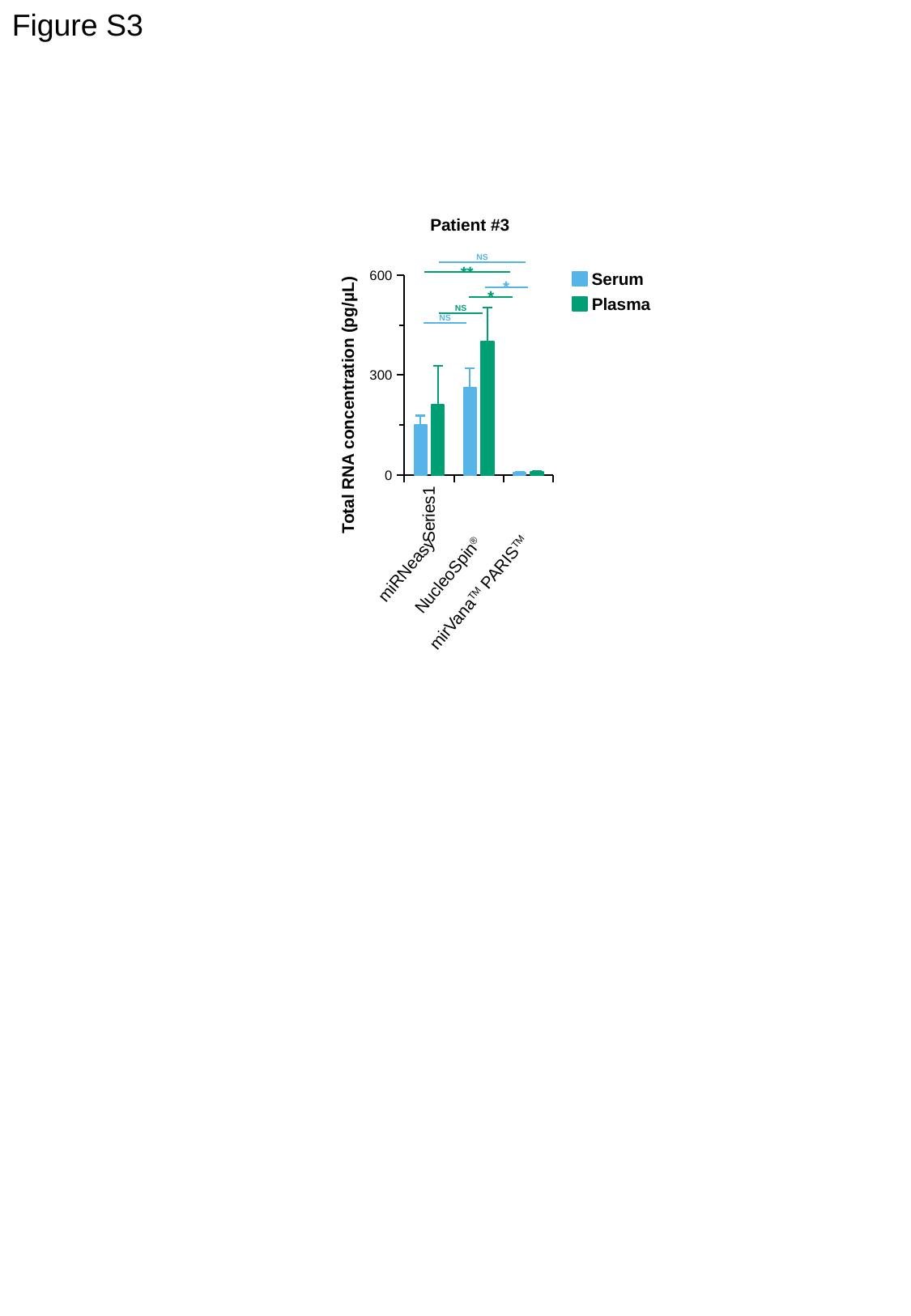
Is the Serum value for NucleoSpin greater or less than 300? less How many series does the legend list? 2 Which category and series has the highest bar? NucleoSpin, Plasma For NucleoSpin, which is larger, the Serum value or the Plasma value? Plasma Is the Serum value for miRNeasy greater or less than 300? less What is the label of the y axis? Total RNA concentration (pg/µL) What kind of chart is shown on the slide? Bar chart What is the title of the chart? Patient #3 Is the Plasma value for NucleoSpin greater or less than 300? greater Which category has the lowest total RNA concentration for both Serum and Plasma? mirVana PARIS For miRNeasy, which is larger, the Serum value or the Plasma value? Plasma How many extraction kit categories are shown on the x axis? 3